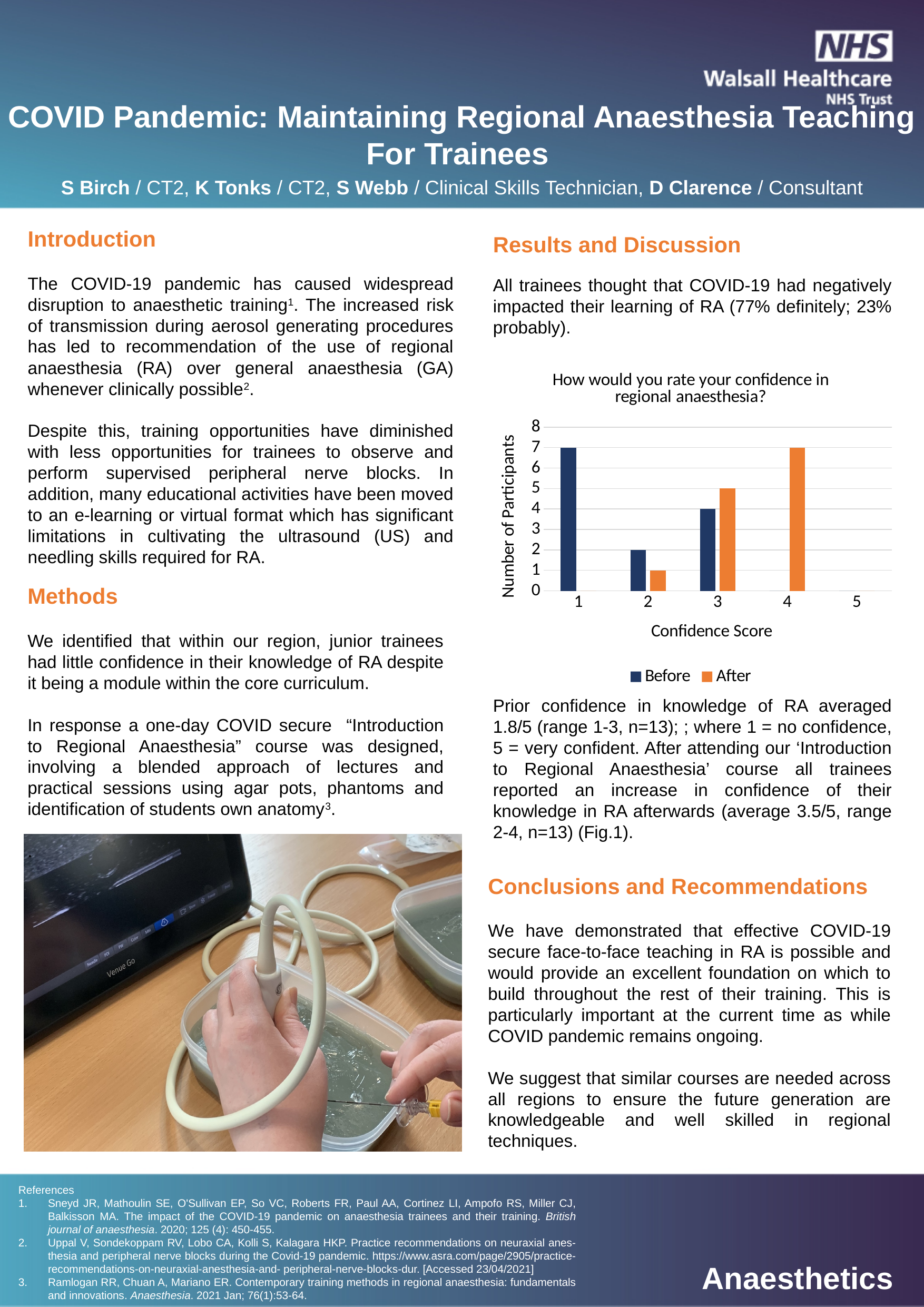
What is the title of the chart? How would you rate your confidence in regional anaesthesia? What is the difference between the Before and After number of participants at confidence score 2? 1 For a confidence score of 3, which series has more participants, Before or After? After How many participants gave a confidence score of 4 after the course? 7 How many participants gave a confidence score of 3 after the course? 5 Is the number of participants with a Before confidence score of 1 greater or less than 5? greater How many participants gave a confidence score of 1 before the course? 7 Which confidence score has the highest number of participants in the After series? 4 What type of chart is shown on the slide? bar chart How many series does the chart legend list? 2 How many confidence score categories are shown on the x axis? 5 Which confidence score has the highest number of participants in the Before series? 1